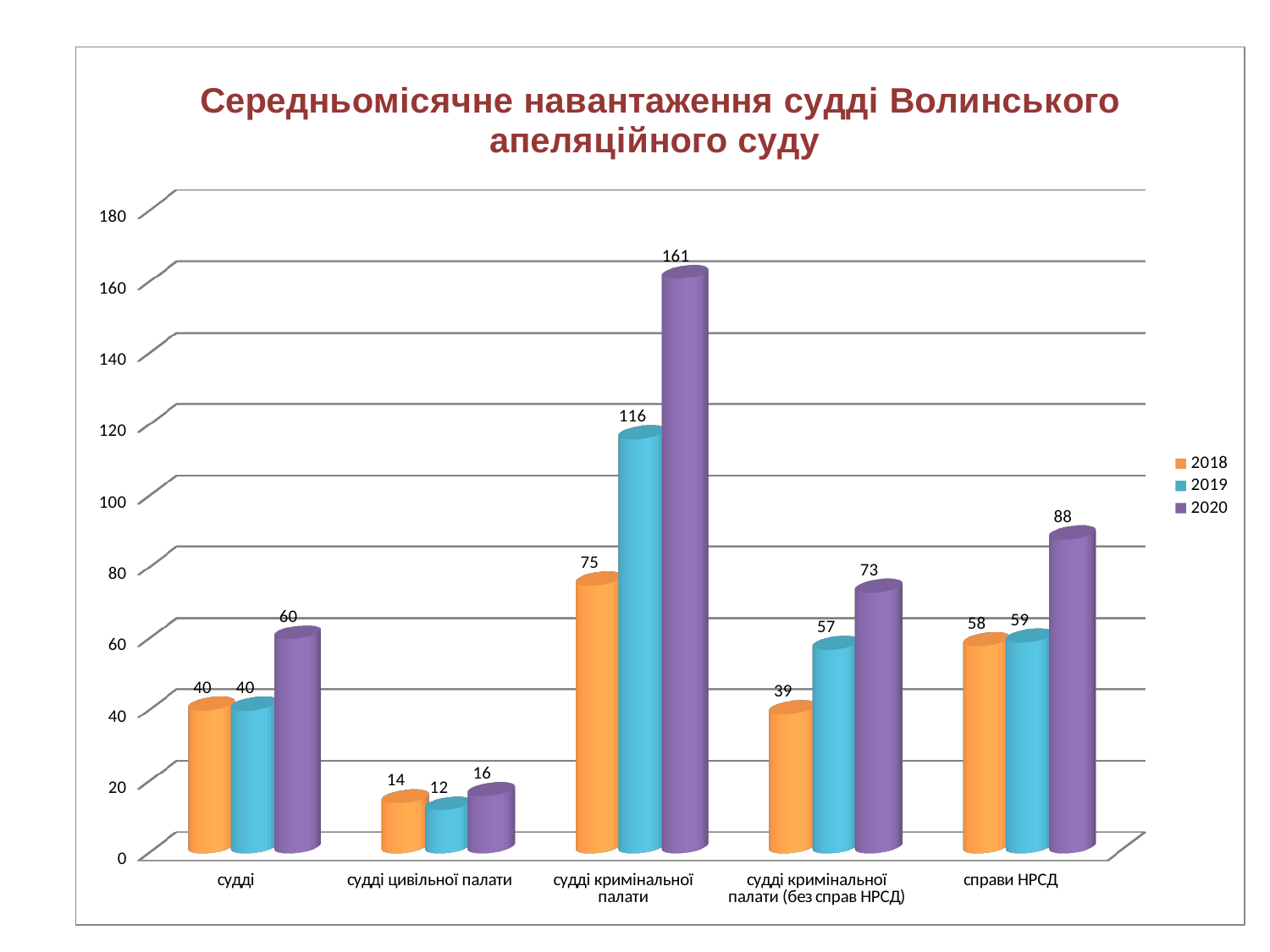
What is the value for 2019 in the category "судді цивільної палати"? 12 What is the value for 2018 in the category "справи НРСД"? 58 Which category has the highest value for the 2020 series? судді кримінальної палати Which category has the lowest value for the 2018 series? судді цивільної палати What is the difference between the 2020 and 2018 values for "судді кримінальної палати"? 86 Is the 2019 value for "судді кримінальної палати" greater or less than 100? greater What is the value for 2020 in the category "судді кримінальної палати"? 161 How many categories are shown on the x axis? 5 Which is larger for "судді кримінальної палати (без справ НРСД)": the 2019 value or the 2020 value? 2020 Which series is shown in purple in the legend? 2020 What kind of chart is shown on the slide? bar chart How many series does the legend list? 3